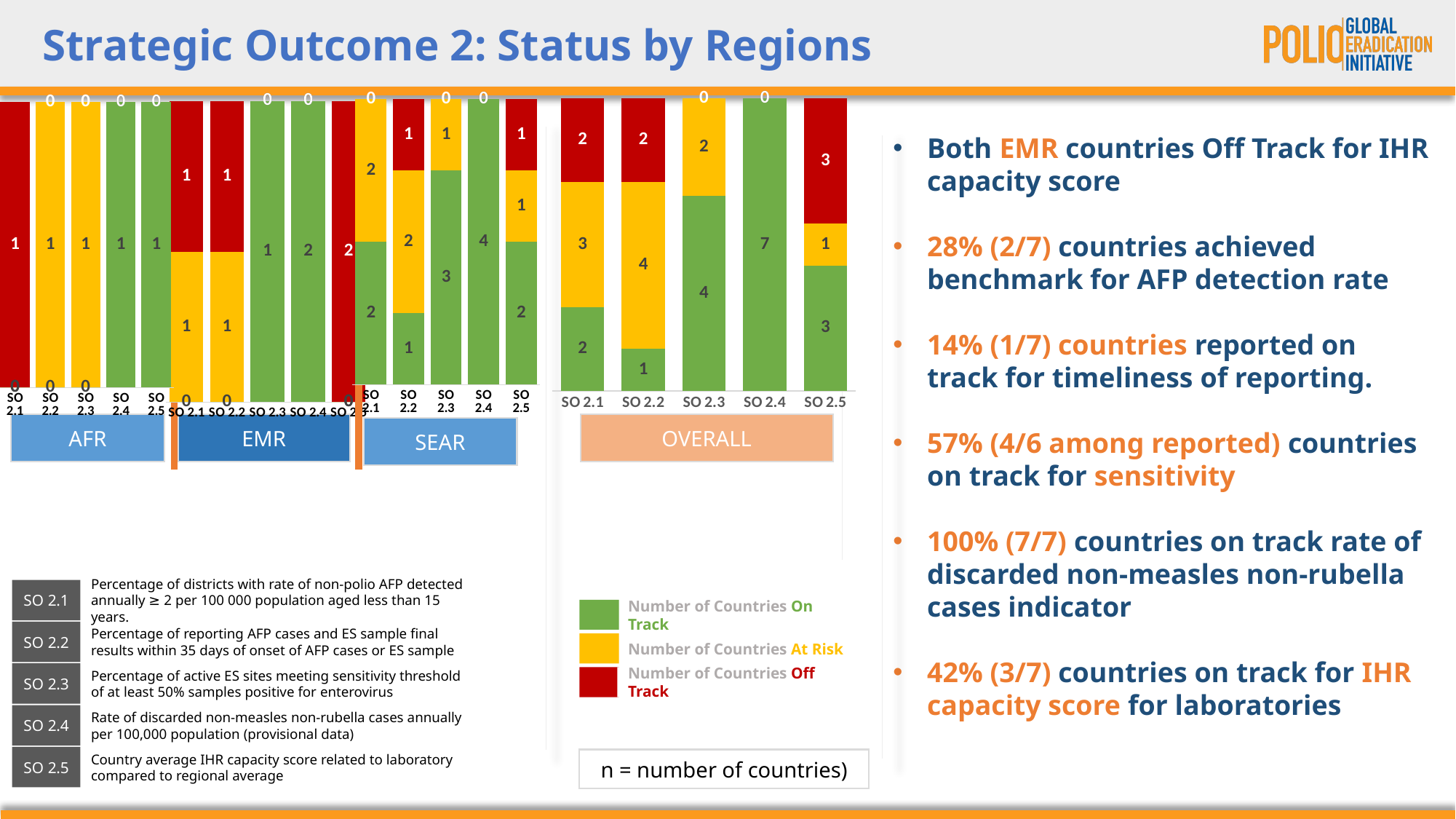
In the OVERALL chart, what is the difference between the number of countries At Risk for SO 2.2 and for SO 2.5? 3 In the OVERALL chart, how many countries are On Track for SO 2.4? 7 In the SEAR chart, is the number of countries On Track for SO 2.4 larger than the number On Track for SO 2.1? Yes In the OVERALL chart, what is the total number of countries in the SO 2.1 bar? 7 In the EMR chart, how many countries are Off Track for SO 2.5? 2 In the OVERALL chart, which indicator has the highest number of countries On Track? SO 2.4 In the OVERALL chart, how many countries are At Risk for SO 2.2? 4 What kind of chart is used to show the status by region? Stacked bar chart In the OVERALL chart, how many countries are Off Track for SO 2.5? 3 In the SEAR chart, how many countries are On Track for SO 2.3? 3 How many series does the legend list? 3 How many indicator categories are shown on the x axis of the OVERALL chart? 5